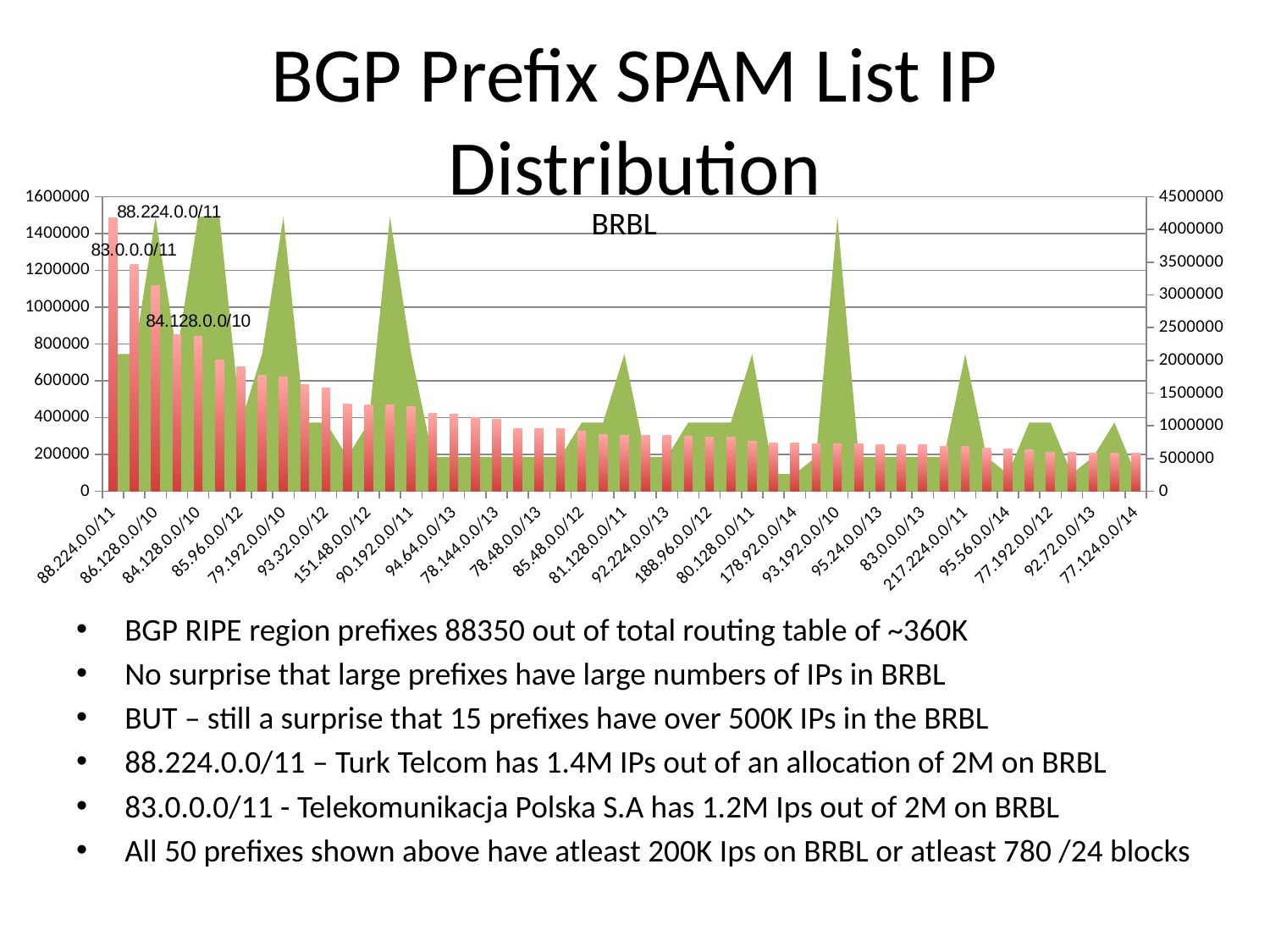
Is the bar value for 84.128.0.0/10 greater or less than 600000 on the left axis? greater Is the bar value for 86.128.0.0/10 greater or less than 1000000 on the left axis? greater How many prefixes are plotted as bars in the chart? 49 What kind of chart is shown on the slide? A bar chart combined with an area chart What is the title of the chart on the slide? BRBL Is the bar value for 77.124.0.0/14 greater or less than 400000 on the left axis? less What is the maximum value shown on the left vertical axis of the chart? 1600000 Which has the taller bar, 88.224.0.0/11 or 86.128.0.0/10? 88.224.0.0/11 Which has the taller bar, 86.128.0.0/10 or 93.32.0.0/12? 86.128.0.0/10 Which prefix has the tallest bar in the BRBL chart? 88.224.0.0/11 Do the bar values generally rise or fall from left to right along the x axis? fall